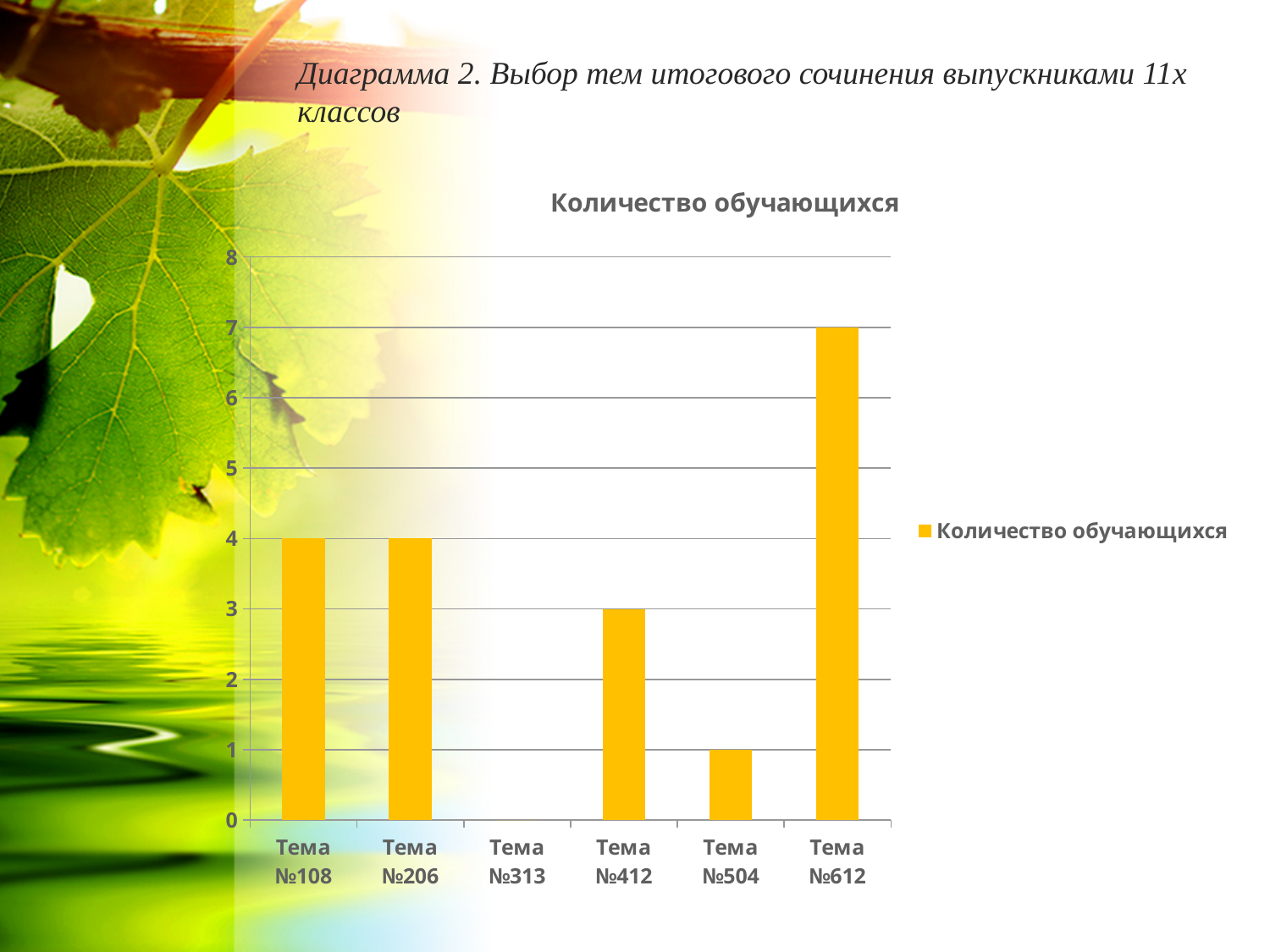
Which category has the highest value? Тема №612 What is the value for Тема №612? 7 What is the title of the chart? Количество обучающихся What is the difference between the values for Тема №612 and Тема №504? 6 What is the value for Тема №504? 1 How many series does the legend list? 1 Which is larger, the value for Тема №206 or the value for Тема №412? Тема №206 Which category has the lowest value? Тема №313 What is the value for Тема №108? 4 What type of chart is shown on the slide? bar chart What is the value for Тема №412? 3 How many categories are shown on the x axis? 6